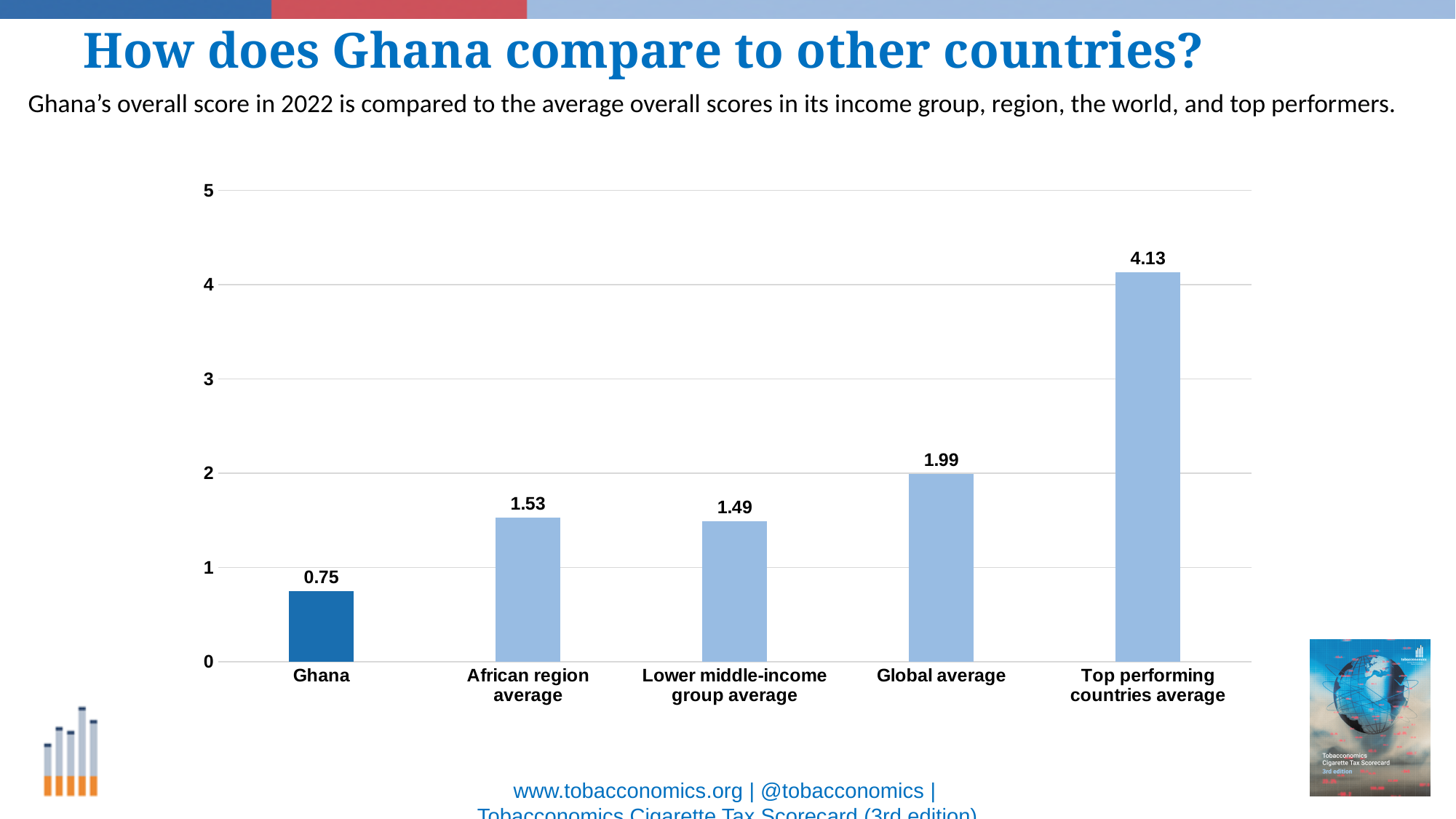
What is the overall score shown for Ghana? 0.75 Which is larger, the Global average or the African region average? Global average What kind of chart is shown on the slide? Bar chart What is the value shown for the Global average? 1.99 What is the difference between the Top performing countries average and Ghana's score? 3.38 How many categories are shown on the chart? 5 Which bar is shown in a darker blue than the others? Ghana What is the difference between the Global average and the African region average? 0.46 Which category has the highest value? Top performing countries average Which category has the lowest value? Ghana What is the value shown for the Top performing countries average? 4.13 What is the value shown for the Lower middle-income group average? 1.49